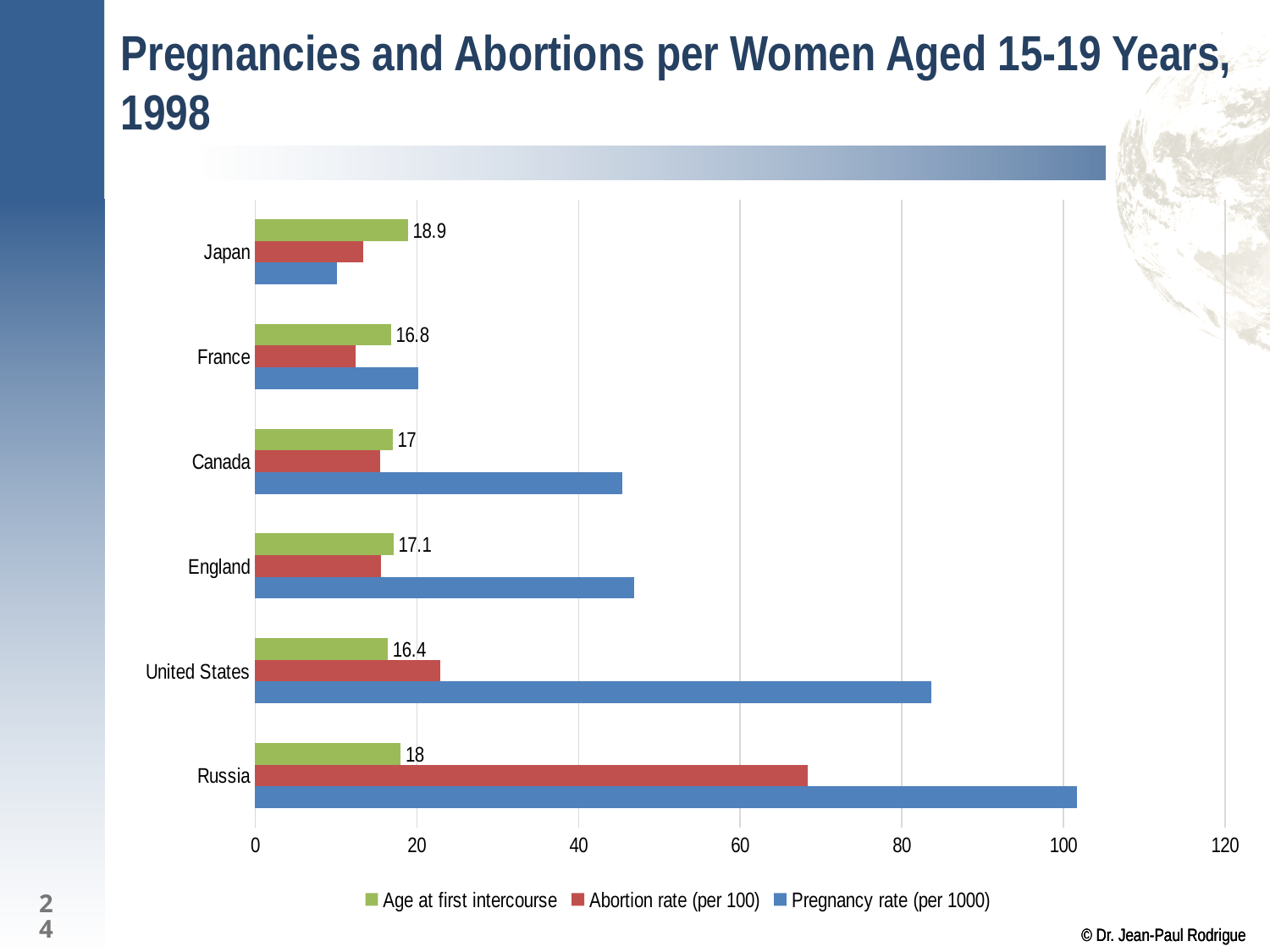
Which country has a larger abortion rate (per 100), Russia or the United States? Russia Is the pregnancy rate (per 1000) for the United States greater or less than 60? greater Which country has the highest age at first intercourse? Japan What kind of chart is shown on the slide? Bar chart How many series does the legend list? 3 What is the age at first intercourse value shown for Japan? 18.9 What is the difference between the age at first intercourse for Japan and for the United States? 2.5 Which country has the lowest age at first intercourse? United States How many countries are shown on the chart? 6 What is the age at first intercourse value shown for Canada? 17 What is the age at first intercourse value shown for the United States? 16.4 Which country has the highest pregnancy rate (per 1000)? Russia